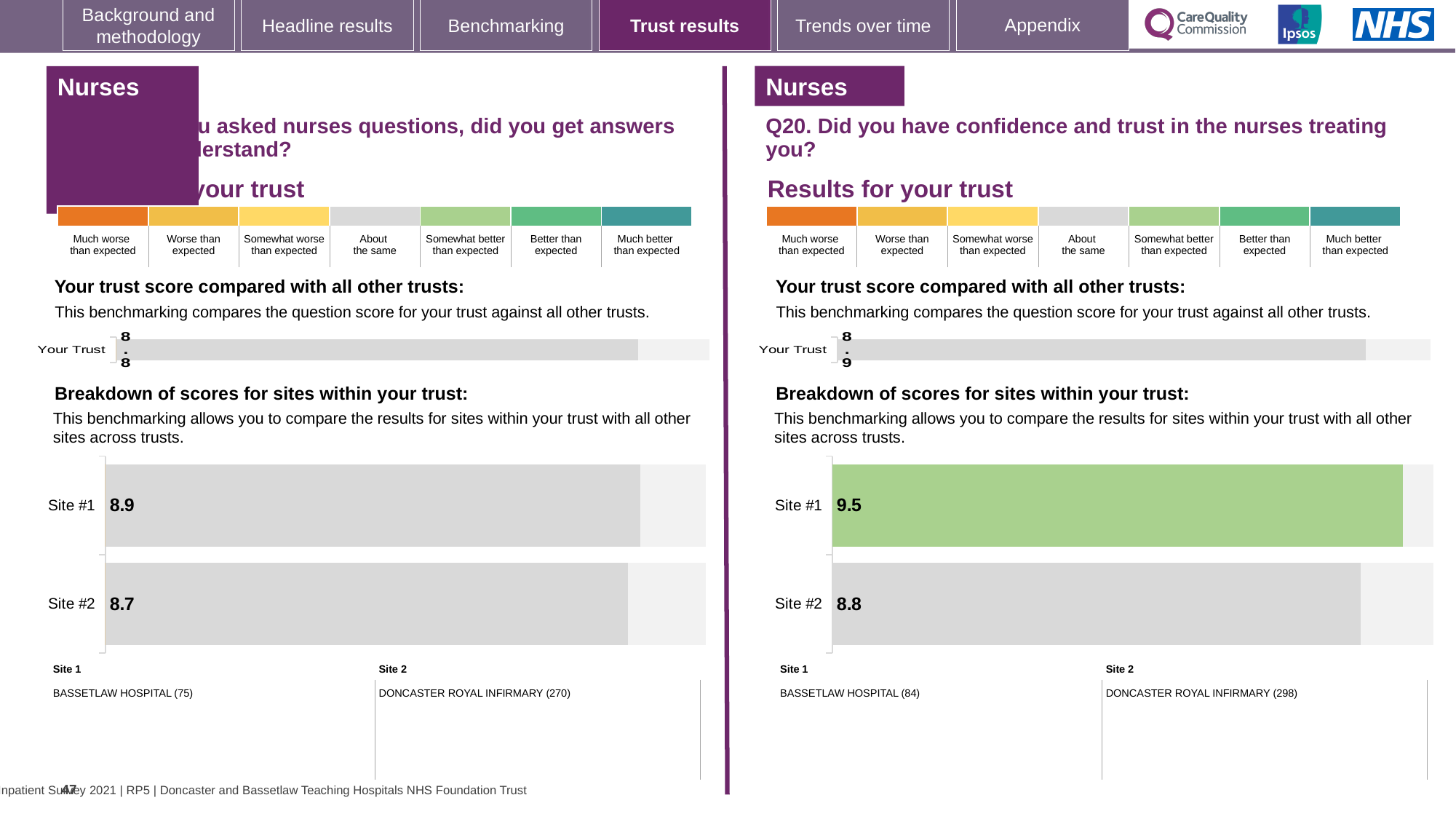
On the left-hand site breakdown chart, what is the score for Site #2? 8.7 On the right-hand site breakdown chart for Q20, what is the difference between the Site #1 and Site #2 scores? 0.7 On the left-hand site breakdown chart, what is the difference between the Site #1 and Site #2 scores? 0.2 On the right-hand chart for Q20 (confidence and trust in nurses), what is the score for Site #2? 8.8 On the left-hand 'Your trust score compared with all other trusts' chart, what is the score for Your Trust? 8.8 On the left-hand site breakdown chart, what is the score for Site #1? 8.9 How many sites are shown in the right-hand site breakdown chart for Q20? 2 On the left-hand site breakdown chart, which site has the lower score? Site #2 What type of chart is used for the site breakdown on the right-hand side for Q20? Bar chart On the right-hand chart for Q20 (confidence and trust in nurses), what is the score for Site #1? 9.5 On the right-hand site breakdown chart for Q20, which site has the higher score? Site #1 On the right-hand 'Your trust score compared with all other trusts' chart for Q20, what is the score for Your Trust? 8.9